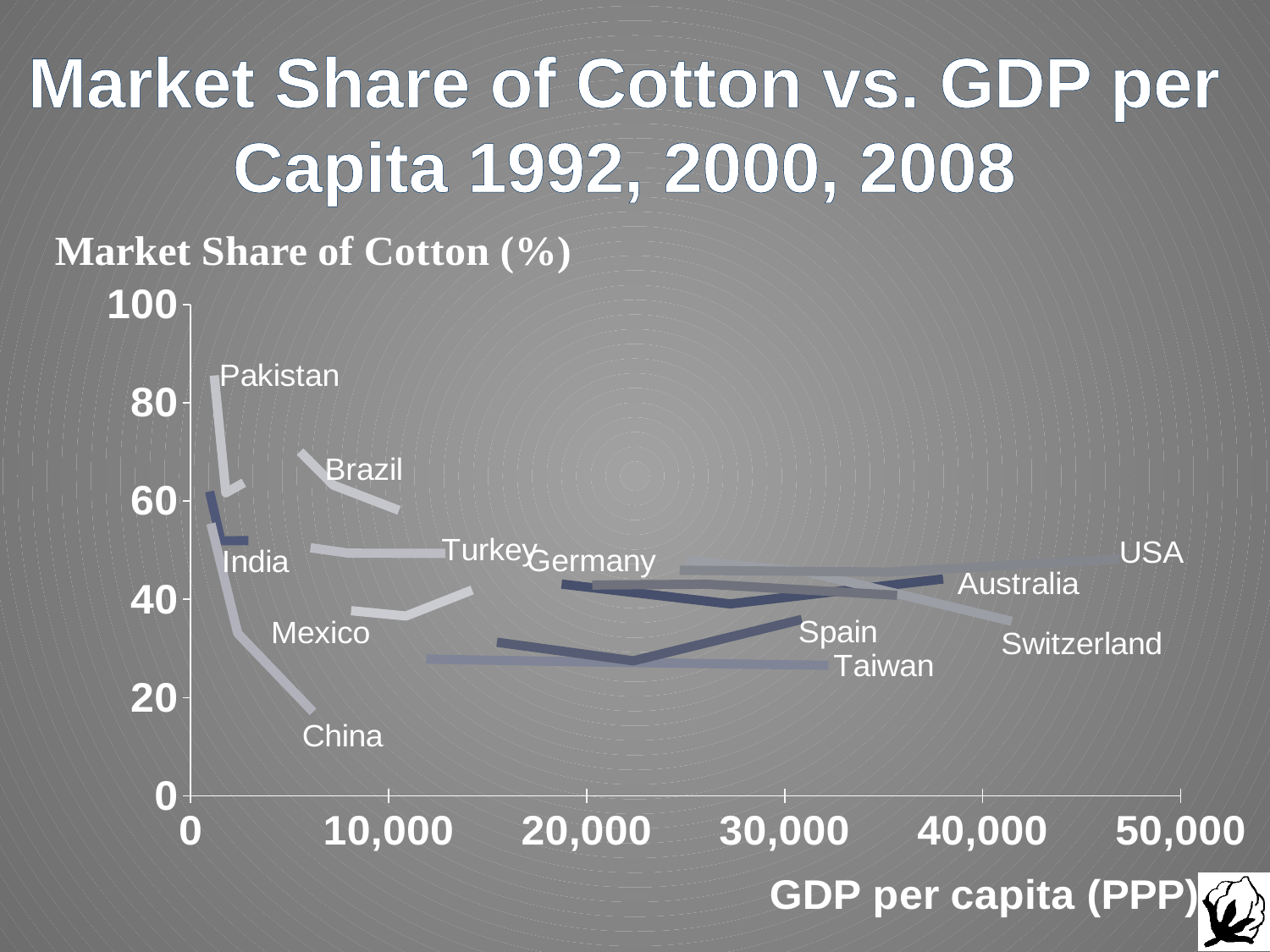
How many countries are labelled on the chart? 12 Is the market share for Taiwan greater or less than 40? less What is the label of the y axis? Market Share of Cotton (%) Does the market share of cotton for China rise or fall as GDP per capita increases? fall Which has a higher market share of cotton, USA or Taiwan? USA Which country reaches the highest market share of cotton on the chart? Pakistan What kind of chart is shown on the slide? line chart Is the market share for USA greater or less than 40? greater Is the lowest value for China greater or less than 20? less Which country reaches the lowest market share of cotton on the chart? China What is the label of the x axis? GDP per capita (PPP)